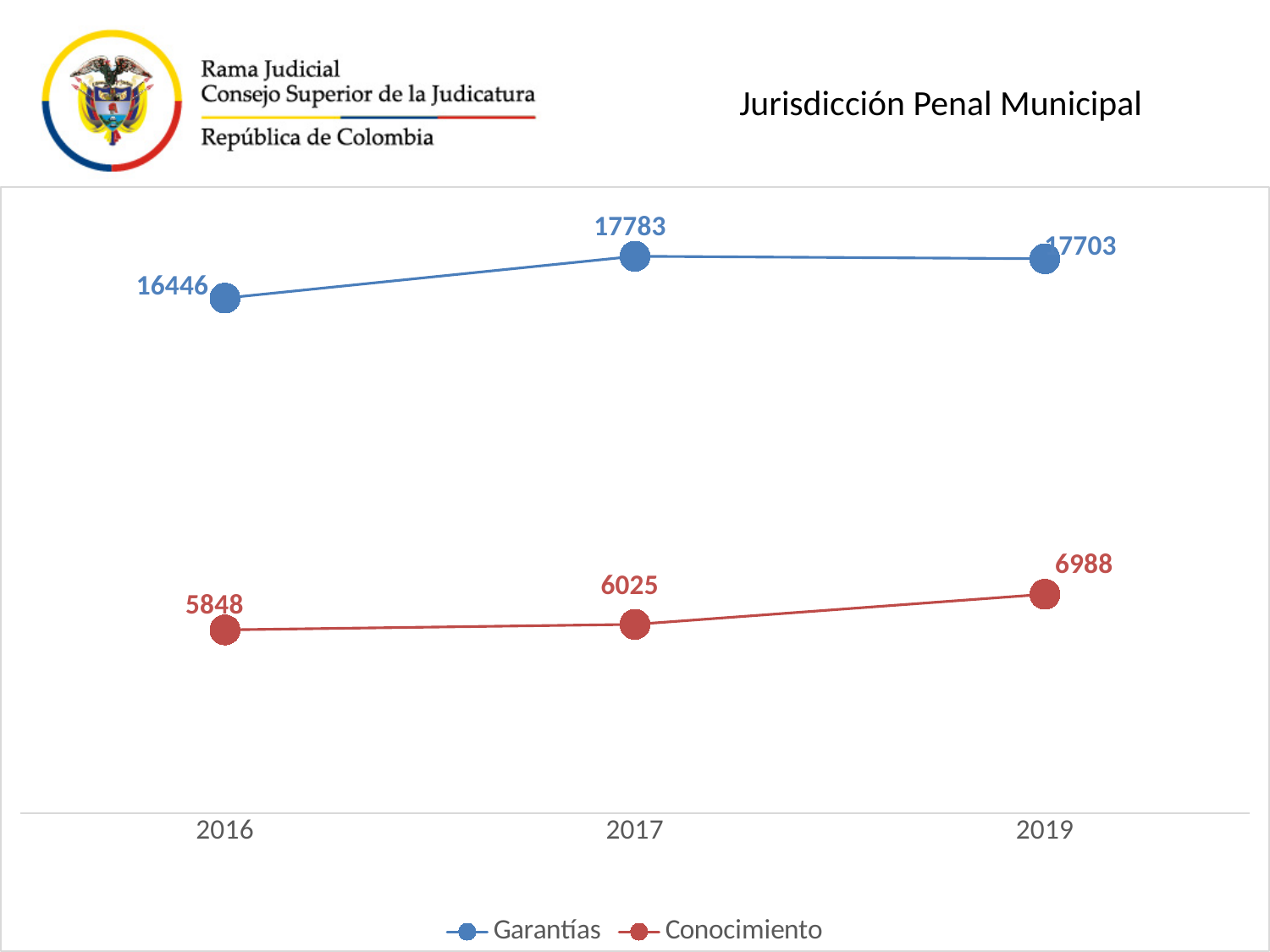
What is the difference between Garantías in 2017 and Garantías in 2016? 1337 In which year is Garantías highest? 2017 In which year is Conocimiento lowest? 2016 What is the value for Garantías in 2017? 17783 What is the value for Conocimiento in 2017? 6025 How many series does the legend list? 2 What is the value for Garantías in 2016? 16446 Which is larger in 2016, Garantías or Conocimiento? Garantías How many years are shown on the x axis? 3 What kind of chart is shown? line chart What is the value for Conocimiento in 2019? 6988 What is the difference between Garantías and Conocimiento in 2019? 10715